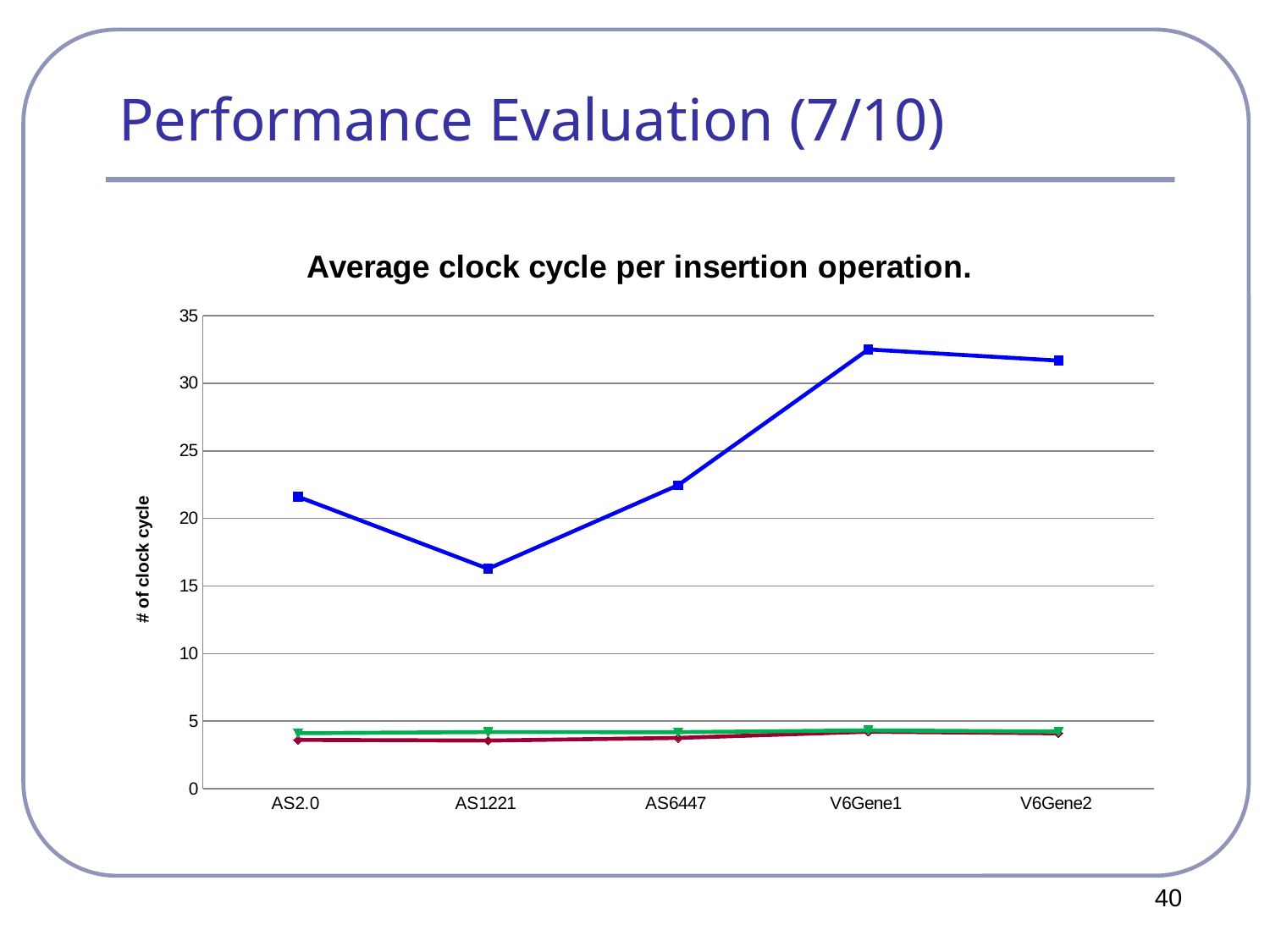
What is the label on the vertical axis of the chart? # of clock cycle What is the title of the chart? Average clock cycle per insertion operation. Is the blue line's value for V6Gene1 greater or less than 30? greater What kind of chart is shown on the slide? line chart How many lines are plotted on the chart? 3 Does the blue line rise or fall from AS1221 to V6Gene1? rise How many categories are shown along the x axis? 5 For which category does the blue line reach its lowest value? AS1221 Is the green line's value for AS6447 greater or less than 5? less Is the blue line's value for AS2.0 greater or less than 20? greater For which category does the blue line reach its highest value? V6Gene1